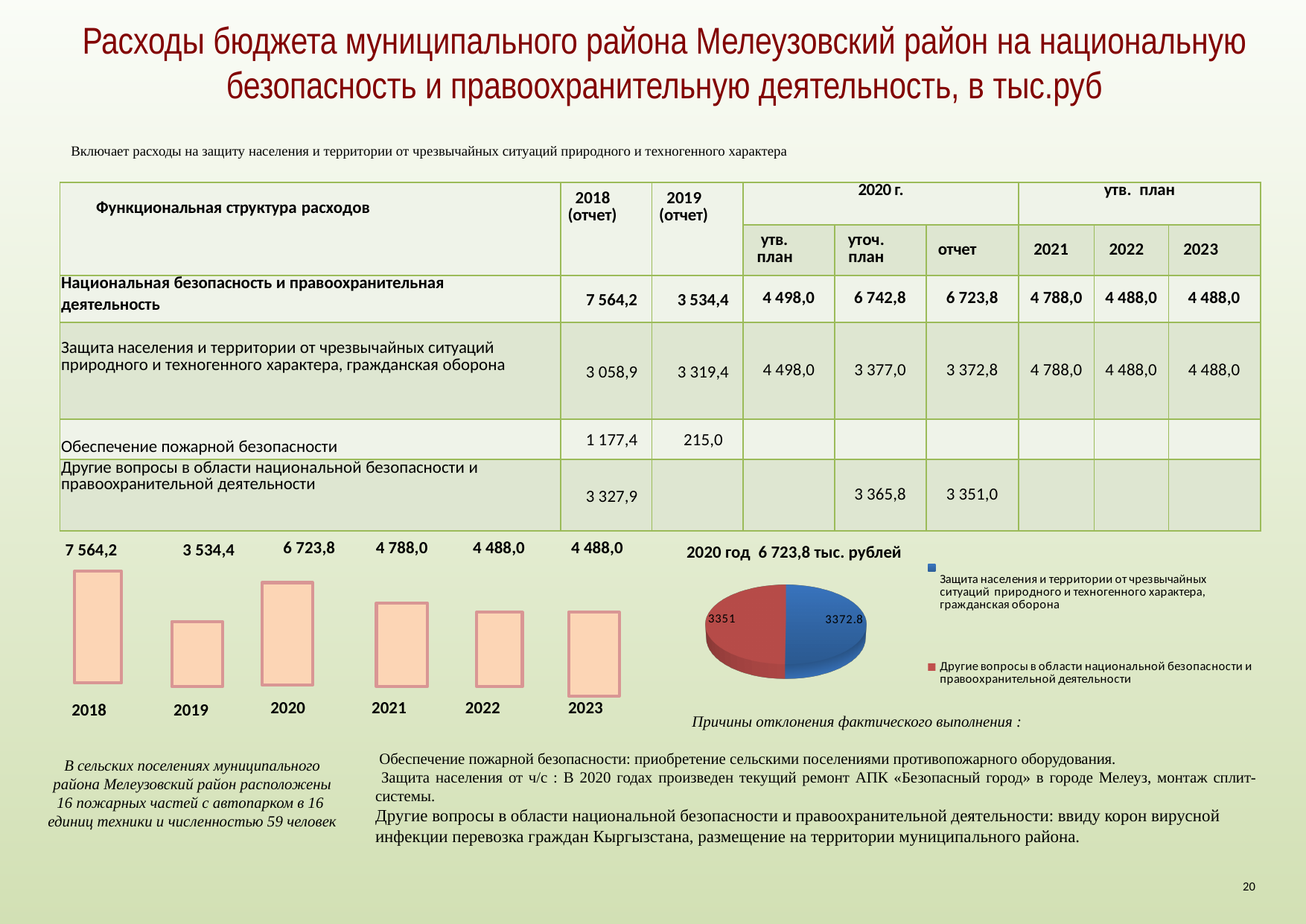
What type of chart is titled '2020 год 6 723,8 тыс. рублей'? pie chart In the bar chart on the left, which is larger: the value for 2020 or the value for 2021? 2020 In the bar chart on the left, which year has the lowest value? 2019 In the bar chart on the left, what is the value for 2018? 7 564,2 In the bar chart on the left, what is the difference between the values for 2018 and 2019? 4 029,8 In the bar chart on the left, what is the value for 2020? 6 723,8 What type of chart is shown at the bottom left of the slide? bar chart In the bar chart on the left, does the value rise or fall from 2018 to 2019? fall How many bars are in the bar chart on the left? 6 In the bar chart on the left, which year has the highest value? 2018 How many entries does the legend of the pie chart '2020 год 6 723,8 тыс. рублей' list? 2 In the pie chart '2020 год 6 723,8 тыс. рублей', what is the value of the slice for 'Другие вопросы в области национальной безопасности и правоохранительной деятельности'? 3351